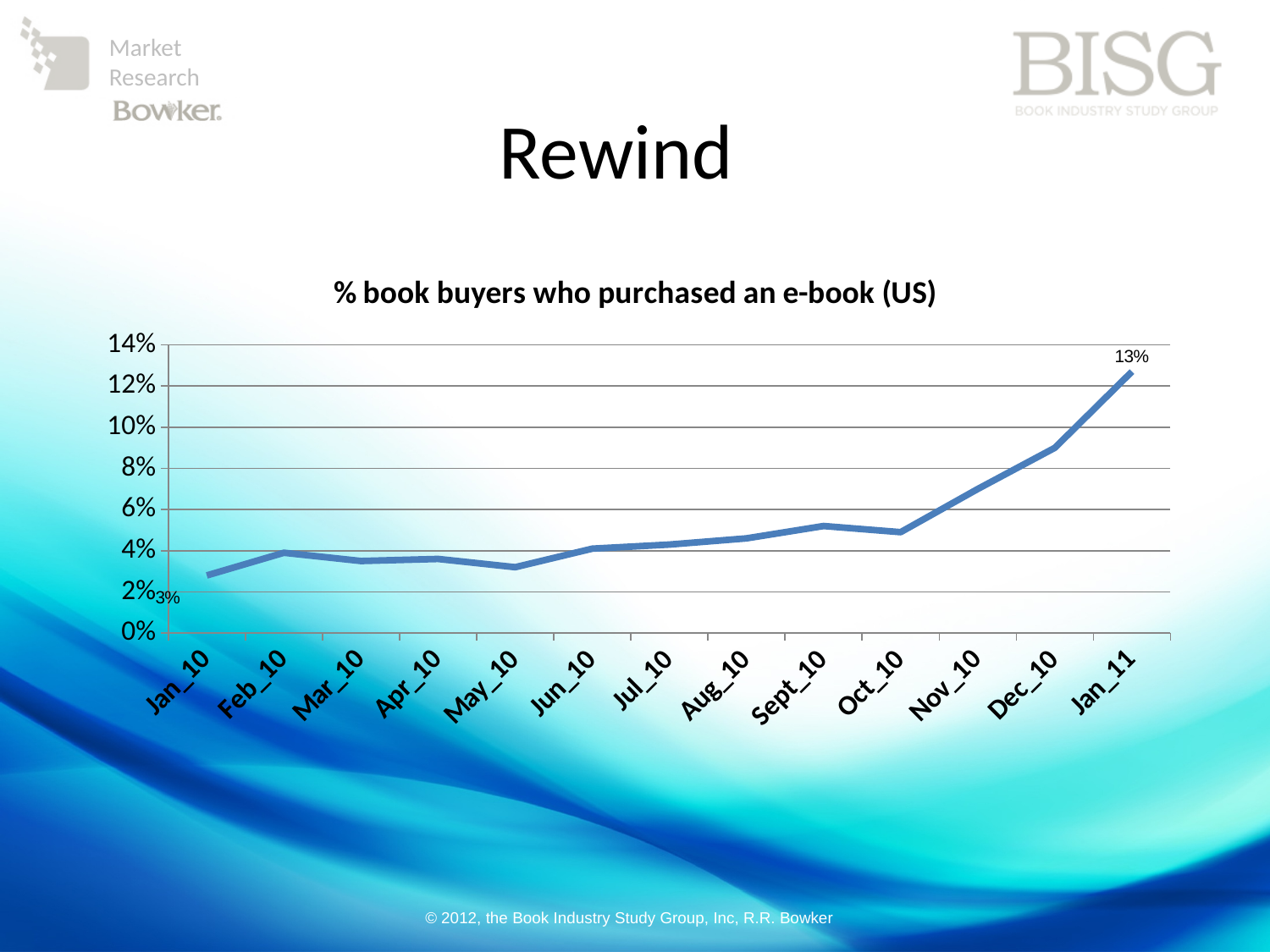
Is the value for Jun_10 greater or less than 6%? less Which is larger, the value for Dec_10 or the value for Nov_10? Dec_10 Is the value for Dec_10 greater or less than 8%? greater What kind of chart is shown? line chart What is the value for Jan_11? 13% Is the value for Sept_10 greater or less than 4%? greater How many months are plotted on the x axis? 13 Which month has the highest value? Jan_11 What is the value for Jan_10? 3% What is the difference between the values for Jan_11 and Jan_10? 10 percentage points Do the values generally rise or fall from Jan_10 to Jan_11? rise